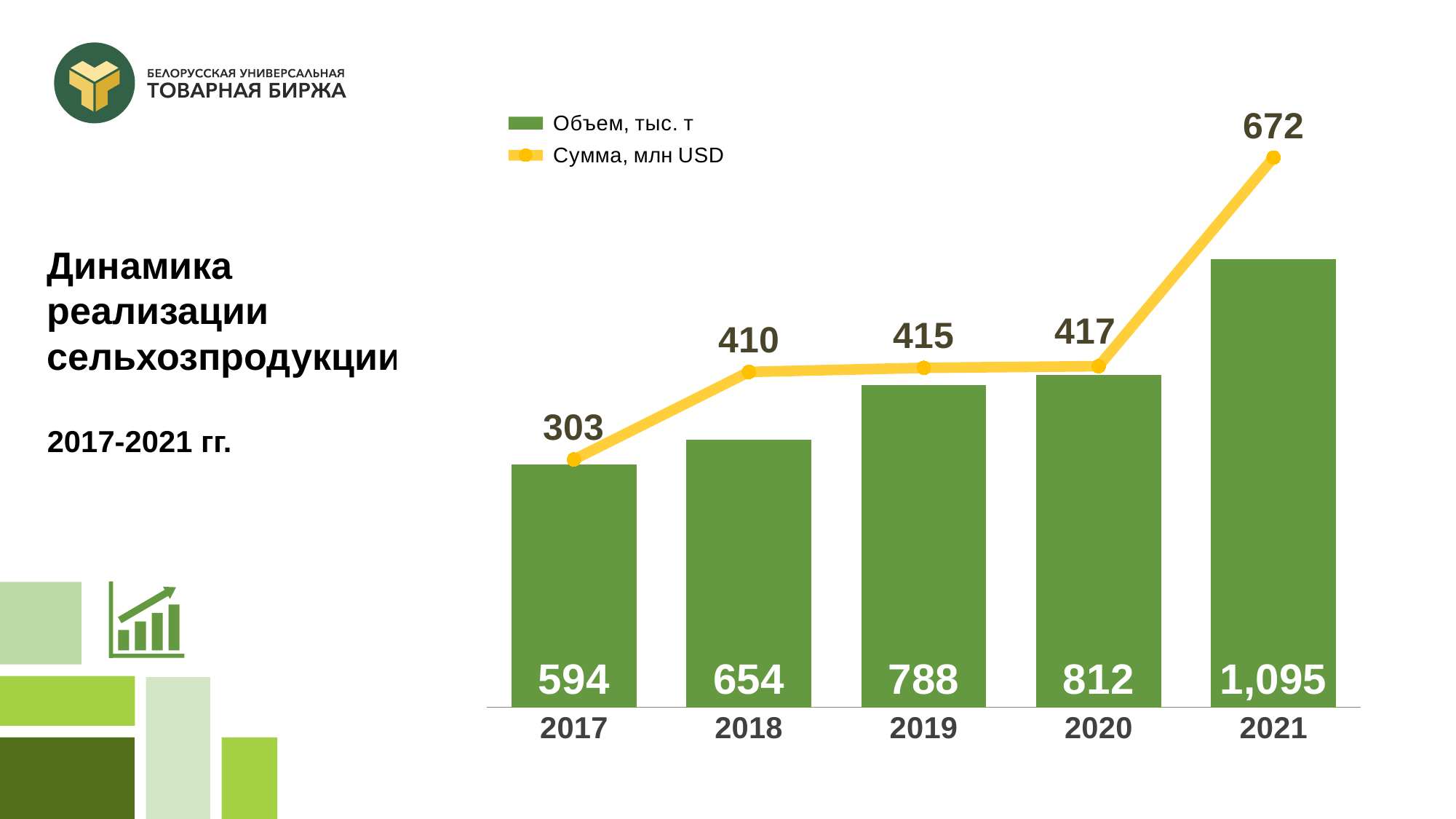
What is the difference in Объем, тыс. т between 2020 and 2019? 24 How many series does the legend list? 2 Which year has the lowest Объем, тыс. т? 2017 Which year has a larger Объем, тыс. т: 2017 or 2018? 2018 How many years are shown on the x axis? 5 What is the value of Сумма, млн USD for 2018? 410 What is the value of Объем, тыс. т for 2021? 1,095 Does Сумма, млн USD rise or fall from 2017 to 2021? rise What is the difference in Сумма, млн USD between 2021 and 2020? 255 Which year has the highest Сумма, млн USD? 2021 What is the value of Объем, тыс. т for 2019? 788 What kind of chart is used for the Объем, тыс. т series? bar chart